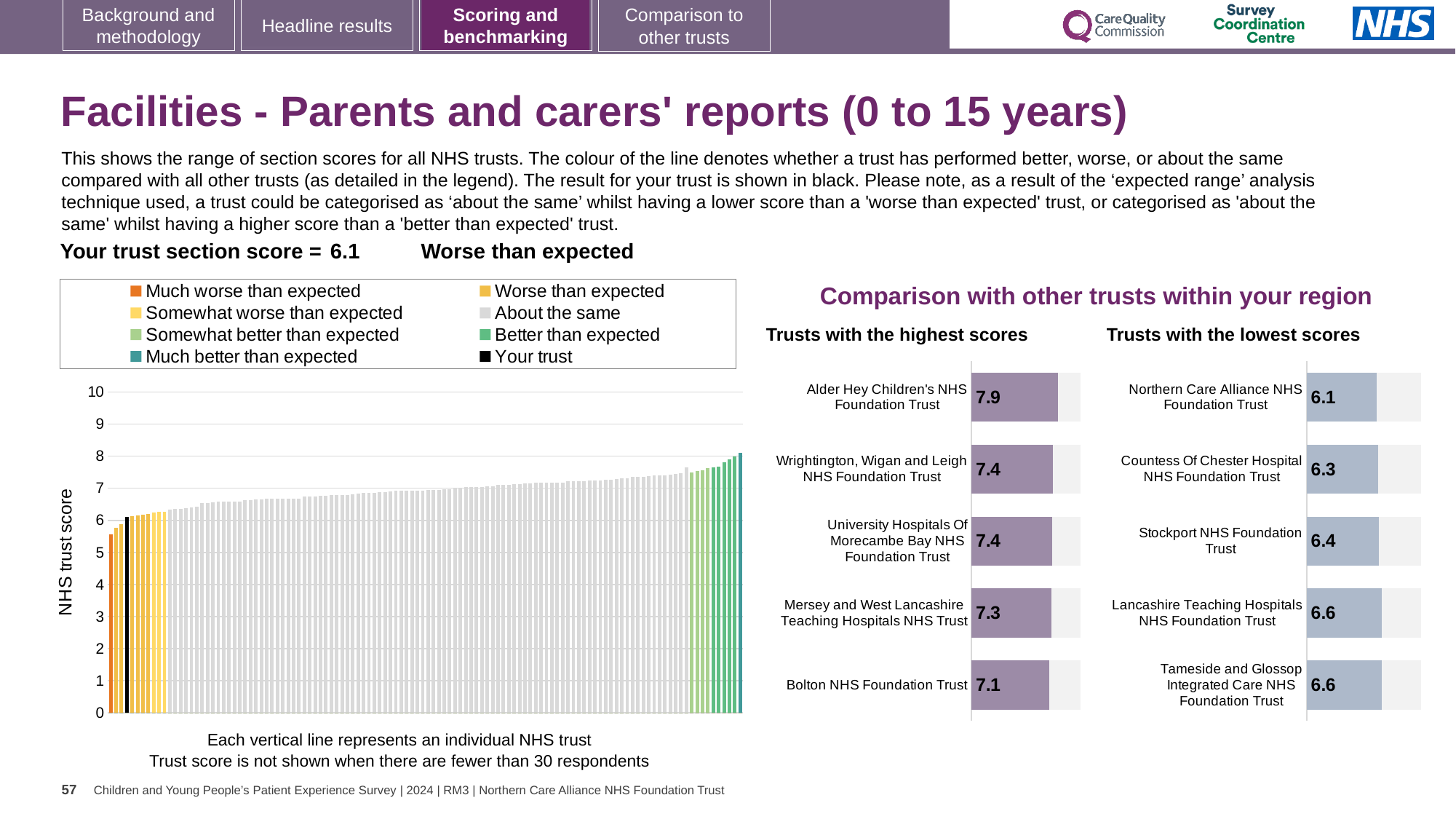
In the NHS trust score chart on the left, is the value for the black 'Your trust' bar greater or less than 5? greater How many trusts are shown in the 'Trusts with the highest scores' chart? 5 In the 'Trusts with the lowest scores' chart, what is the score for Stockport NHS Foundation Trust? 6.4 In the 'Trusts with the lowest scores' chart, how much higher is Lancashire Teaching Hospitals NHS Foundation Trust's score than Northern Care Alliance NHS Foundation Trust's? 0.5 In the 'Trusts with the lowest scores' chart, which trust has the lowest score? Northern Care Alliance NHS Foundation Trust In the 'Trusts with the lowest scores' chart, which has the larger score: Countess Of Chester Hospital NHS Foundation Trust or Stockport NHS Foundation Trust? Stockport NHS Foundation Trust In the 'Trusts with the highest scores' chart, what is the difference between the scores of Alder Hey Children's NHS Foundation Trust and Bolton NHS Foundation Trust? 0.8 In the 'Trusts with the lowest scores' chart, what is the score for Northern Care Alliance NHS Foundation Trust? 6.1 How many entries does the legend of the NHS trust score chart on the left list? 8 In the 'Trusts with the highest scores' chart, what is the score for Bolton NHS Foundation Trust? 7.1 In the 'Trusts with the highest scores' chart, which trust has the highest score? Alder Hey Children's NHS Foundation Trust In the 'Trusts with the highest scores' chart, what is the score for Alder Hey Children's NHS Foundation Trust? 7.9